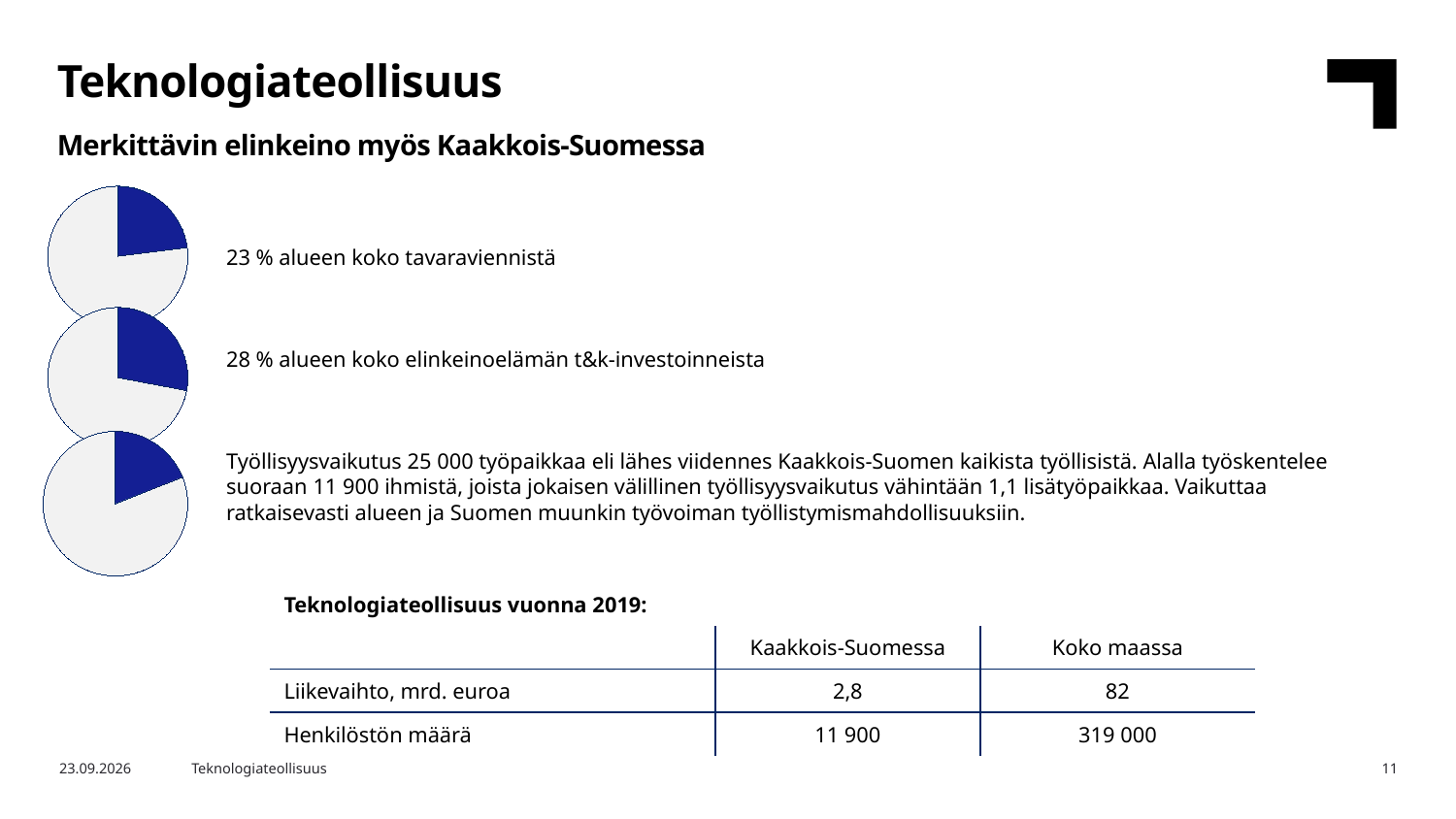
What is the difference in percentage points between the share shown for the middle pie chart (28 %) and the top pie chart (23 %)? 5 percentage points What colour is the highlighted slice in the pie charts? Dark blue What kind of chart is shown at the top left of the slide, next to the text about goods exports? Pie chart How many pie charts are shown on the slide? 3 According to the text beside the top pie chart, what share of the region's total goods exports does the technology industry account for? 23 % Is the highlighted slice in the top pie chart (goods exports) greater or less than 50%? less Is the highlighted slice in the bottom pie chart (employment effect) greater or less than 25%? less According to the text beside the middle pie chart, what share of the region's total business R&D investments does the technology industry account for? 28 % How many slices does each pie chart on the slide have? 2 Which pie chart has the larger highlighted slice, the top one (goods exports) or the middle one (R&D investments)? The middle one (R&D investments)